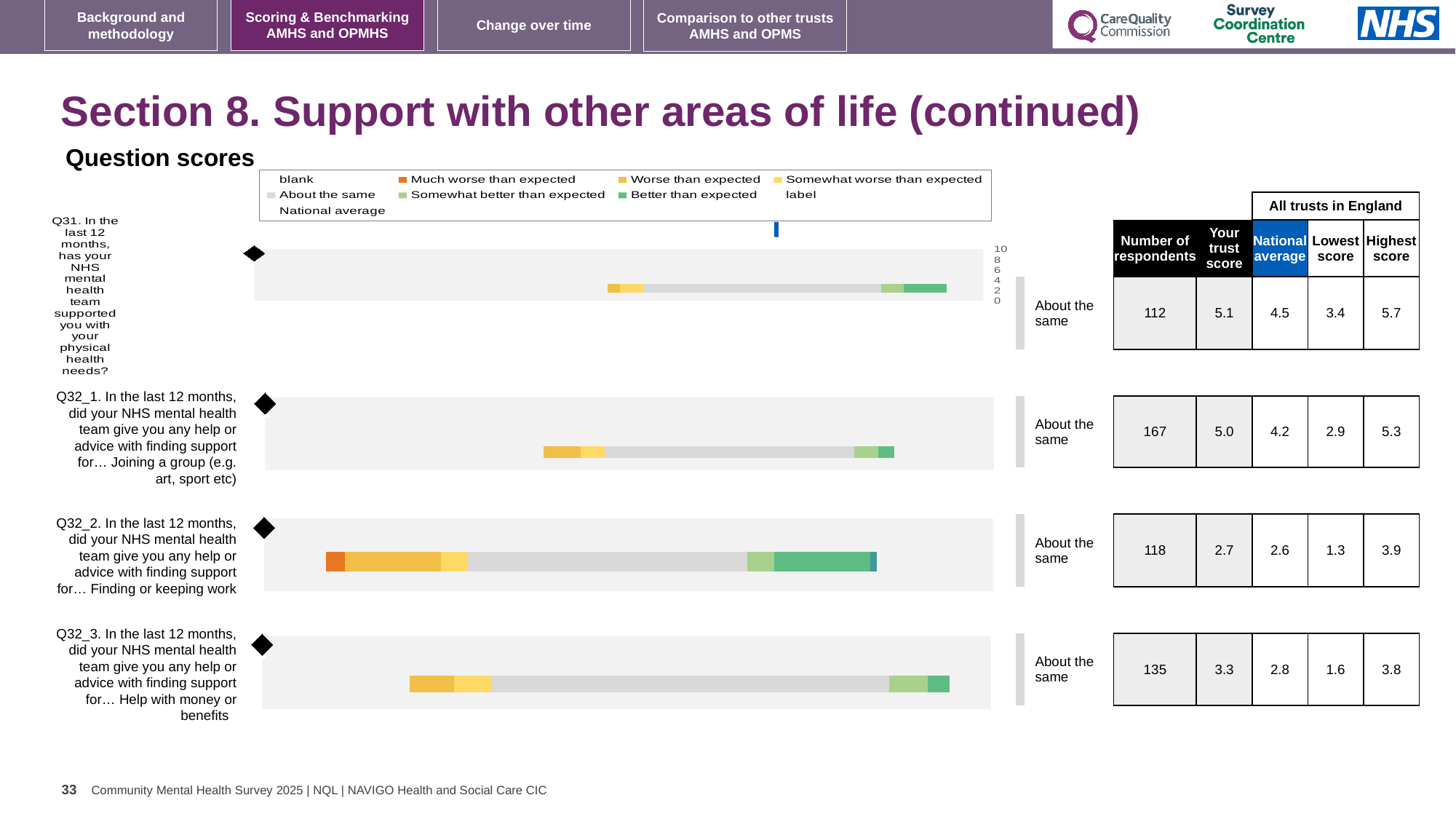
What benchmark category label is shown next to each of the four charts? About the same Which is larger for Q32_1: the trust score or the national average? the trust score What is the national average for Q32_1 (help with joining a group)? 4.2 How many question bar charts are shown on the slide? 4 What kind of chart is used to show the question scores on this slide? bar chart What is the difference between the trust score and the national average for Q32_3? 0.5 Which question has the lowest 'Your trust score'? Q32_2 What is the number of respondents for Q32_2 (finding or keeping work)? 118 What is the 'Your trust score' for Q31 (support with physical health needs)? 5.1 Which question has the highest 'Your trust score'? Q31 What is the highest score among all trusts in England for Q32_3 (help with money or benefits)? 3.8 How many entries does the legend above the charts list? 9